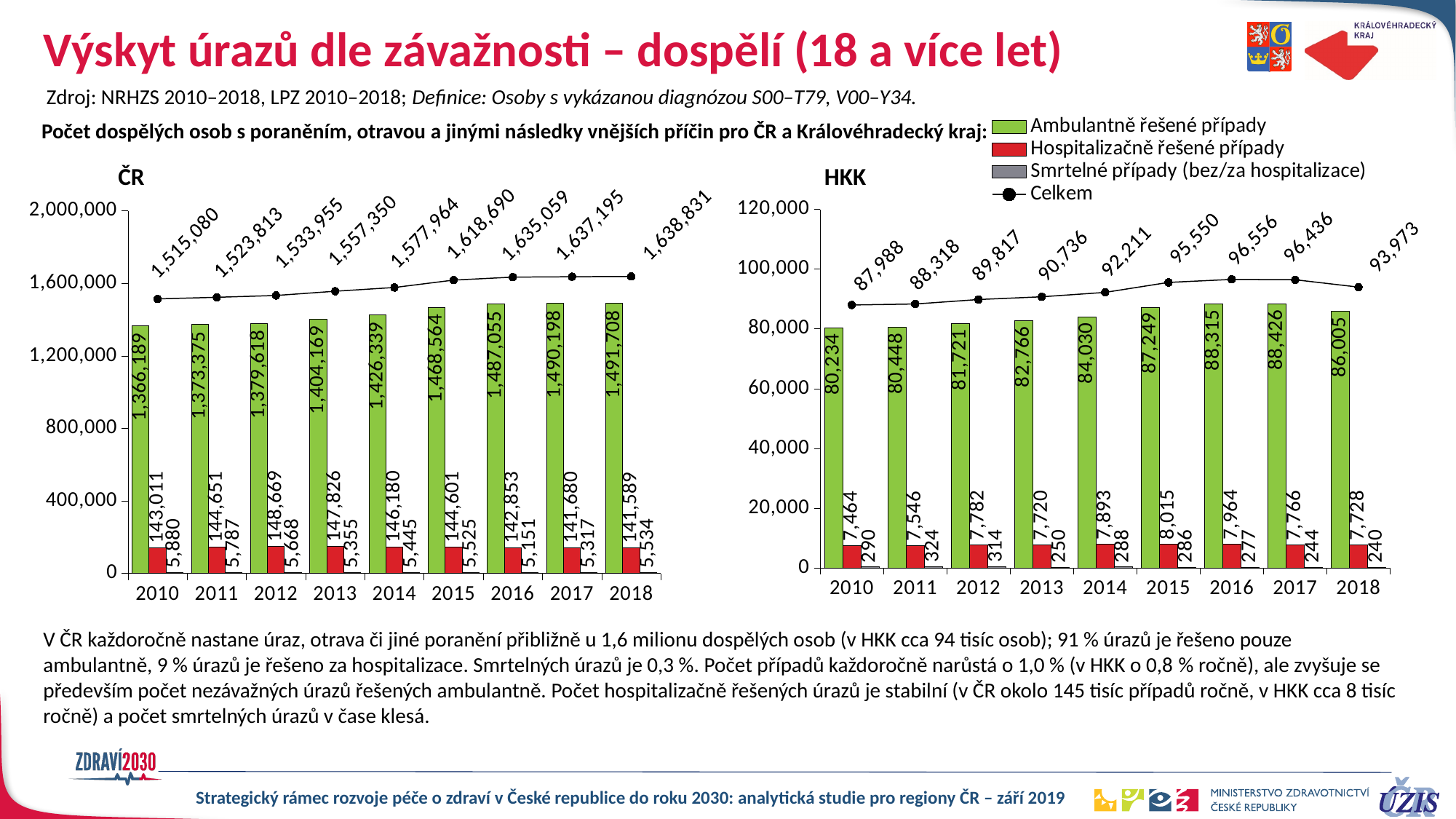
How many series does the legend list? 4 In the ČR chart, what is the value of Hospitalizačně řešené případy for 2012? 148,669 In the HKK chart, what is the difference between the Celkem values for 2018 and 2010? 5,985 In the ČR chart, what is the value of Ambulantně řešené případy for 2018? 1,491,708 How many years are shown on the x axis of the HKK chart? 9 What kind of chart is the ČR chart? bar chart with a line In the ČR chart, is the Ambulantně řešené případy value for 2010 larger or smaller than the value for 2018? smaller In the HKK chart, which year has the highest value of Ambulantně řešené případy? 2017 In the HKK chart, what is the Celkem value for 2010? 87,988 In the ČR chart, does the Celkem line rise or fall from 2010 to 2018? rise In the HKK chart, which year has the lowest value of Smrtelné případy? 2018 In the ČR chart, which year has the highest Celkem value? 2018